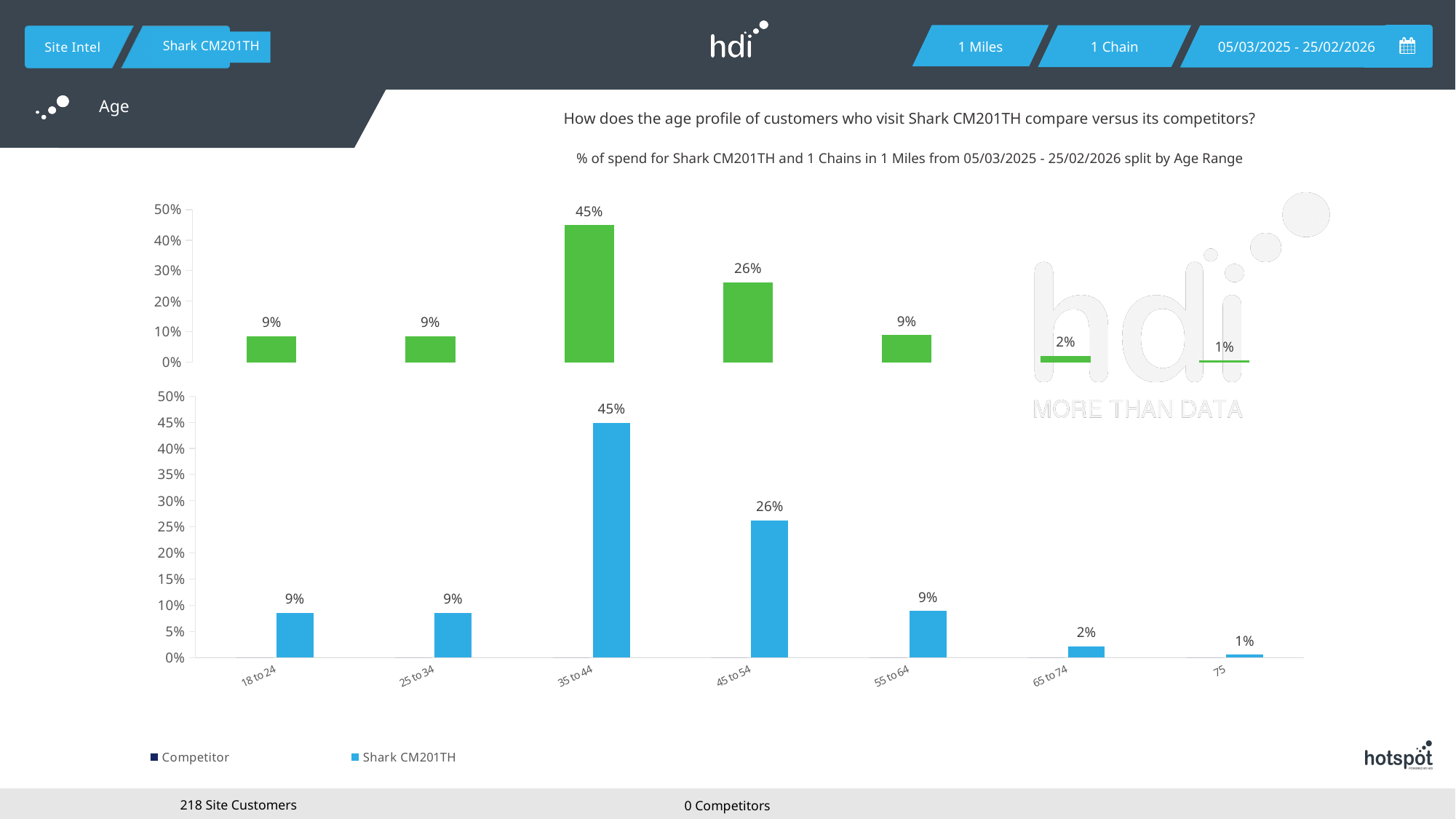
In the bottom chart, what is the value for the 18 to 24 age range? 9% In the bottom chart, what is the value for the 45 to 54 age range? 26% How many age range categories are shown on the x axis of the bottom chart? 7 In the bottom chart, what is the value for the 65 to 74 age range? 2% What kind of chart is the bottom chart? Bar chart How many series does the legend at the bottom of the slide list? 2 In the bottom chart, what is the value for the 35 to 44 age range? 45% In the bottom chart, which age range has the lowest value? 75 In the bottom chart, which age range has the highest value? 35 to 44 In the bottom chart, what is the difference between the values for 35 to 44 and 45 to 54? 19 percentage points In the top chart, what is the highest value shown on a data label? 45% In the bottom chart, which is larger: the value for 18 to 24 or the value for 65 to 74? 18 to 24